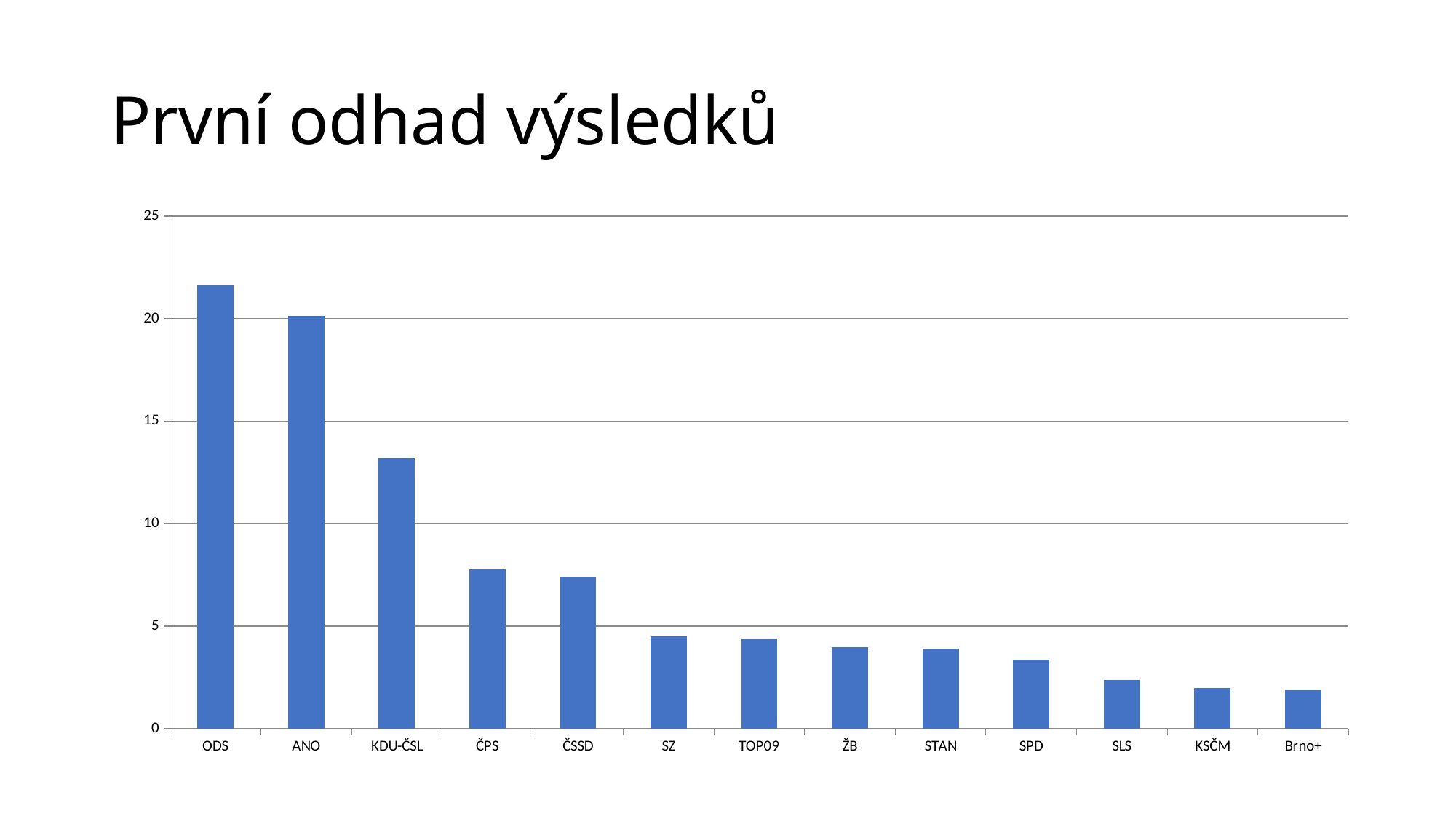
Is the value for SLS greater or less than 5? less Is the value for ČPS greater or less than 5? greater Is the value for KDU-ČSL greater or less than 10? greater How many categories (parties) are shown on the x axis of the chart? 13 Do the bar values rise or fall from left to right along the x axis? fall What kind of chart is shown on the slide? bar chart Which has the larger value, ODS or KDU-ČSL? ODS Which has the larger value, ČPS or SZ? ČPS What is the title of the slide containing the chart? První odhad výsledků Which party has the highest bar in the chart? ODS